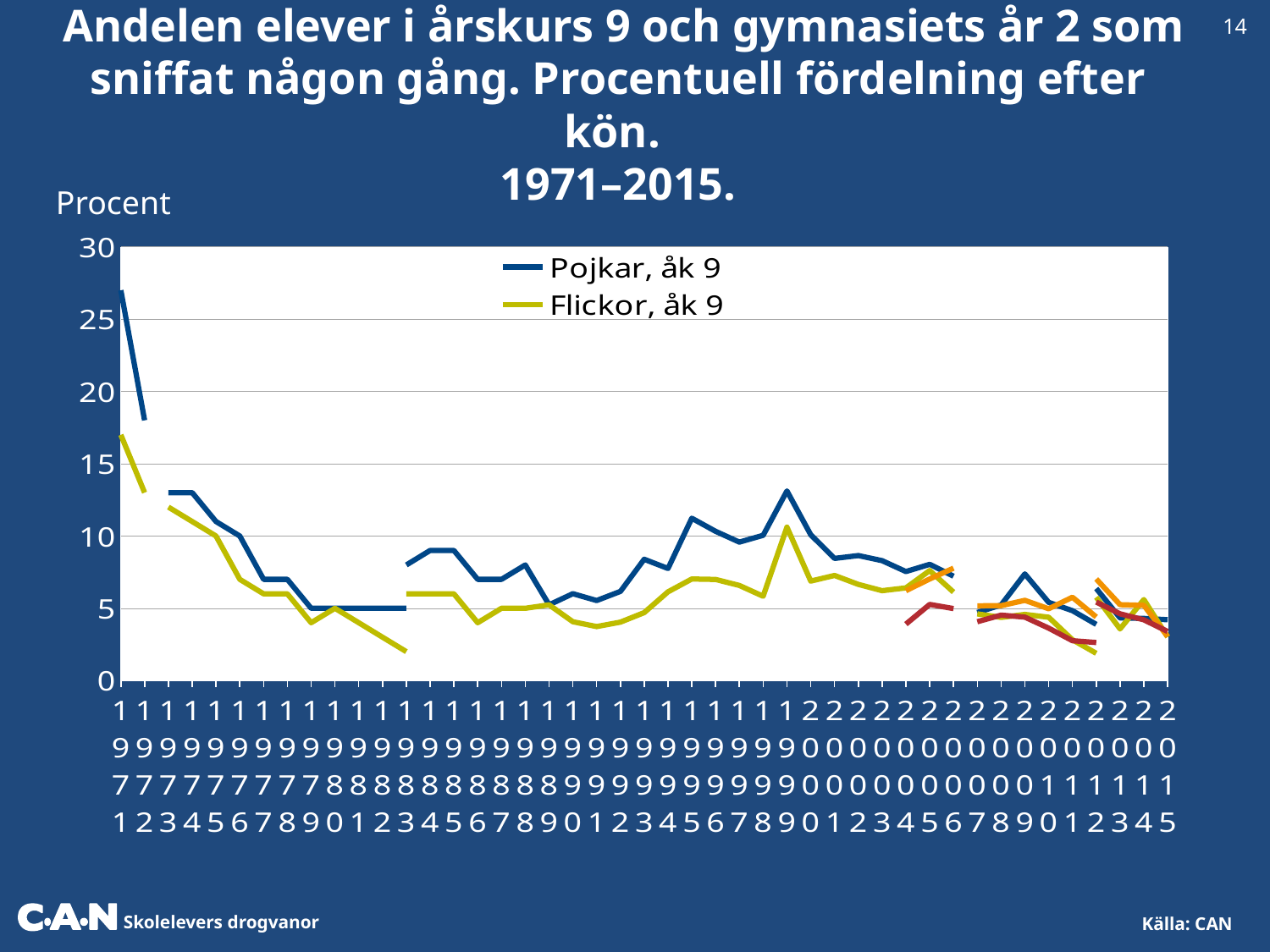
Is the value for Flickor, åk 9 in 1971 greater or less than 15? greater Is the value for Pojkar, åk 9 in 1972 greater or less than 20? less What is the label on the vertical axis? Procent In which year does the Pojkar, åk 9 series reach its highest value? 1971 What kind of chart is shown on the slide? line chart Is the value for Pojkar, åk 9 in 1971 greater or less than 25? greater Overall, do the values for Pojkar, åk 9 rise or fall from 1971 to 2015? fall How many series does the legend list? 2 In 1971, which series has the higher value, Pojkar, åk 9 or Flickor, åk 9? Pojkar, åk 9 Which two series are named in the legend? Pojkar, åk 9 and Flickor, åk 9